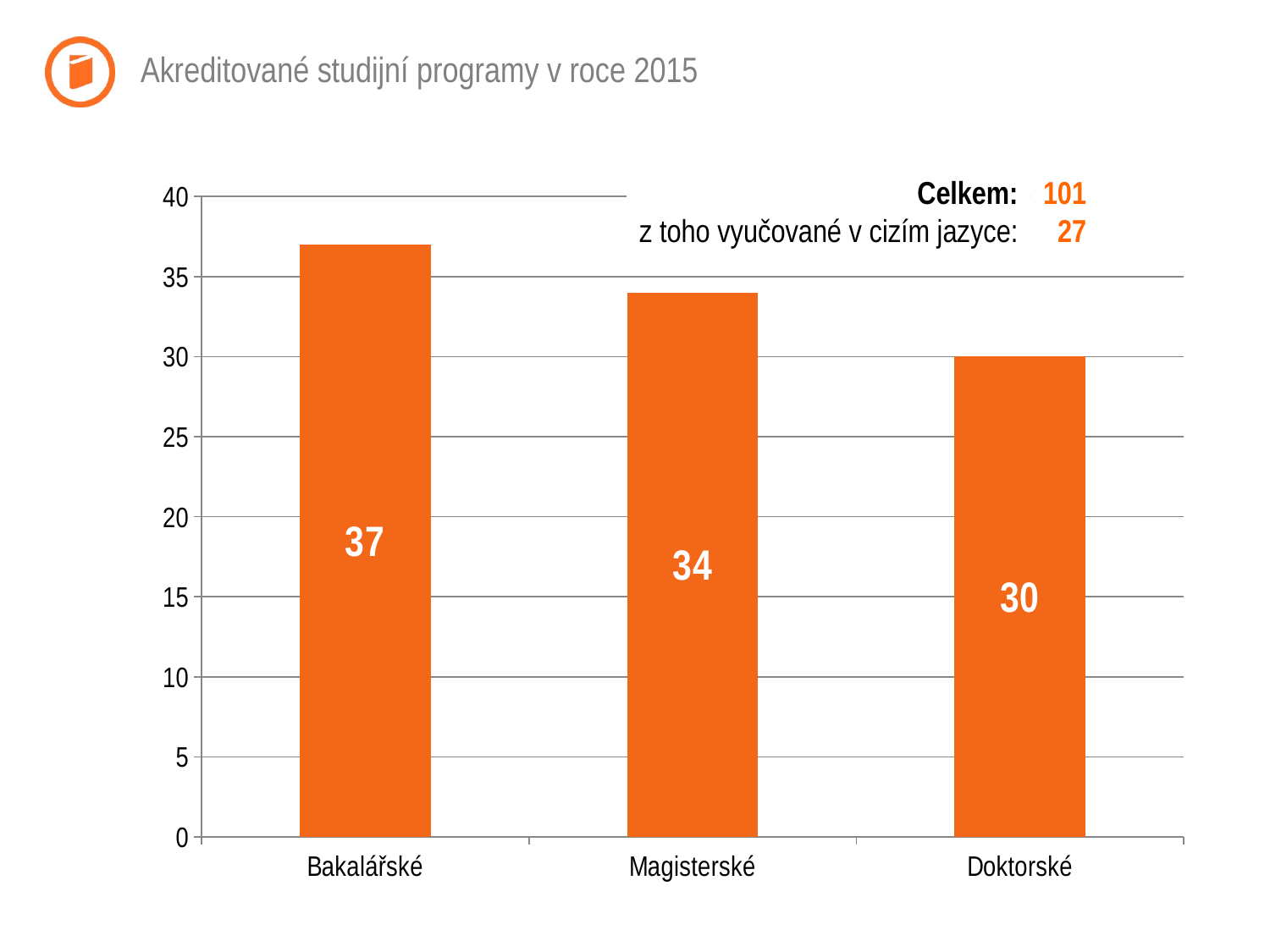
Is the value for Bakalářské greater or less than 35? greater What is the difference between the values for Bakalářské and Doktorské? 7 What is the value for Doktorské? 30 What is the difference between the values for Bakalářské and Magisterské? 3 Which is larger, the value for Magisterské or the value for Doktorské? Magisterské What is the value for Bakalářské? 37 Which category has the highest value? Bakalářské What kind of chart is shown on the slide? bar chart Do the values rise or fall from left to right across the categories? fall Which category has the lowest value? Doktorské What is the value for Magisterské? 34 How many categories are shown in the chart? 3